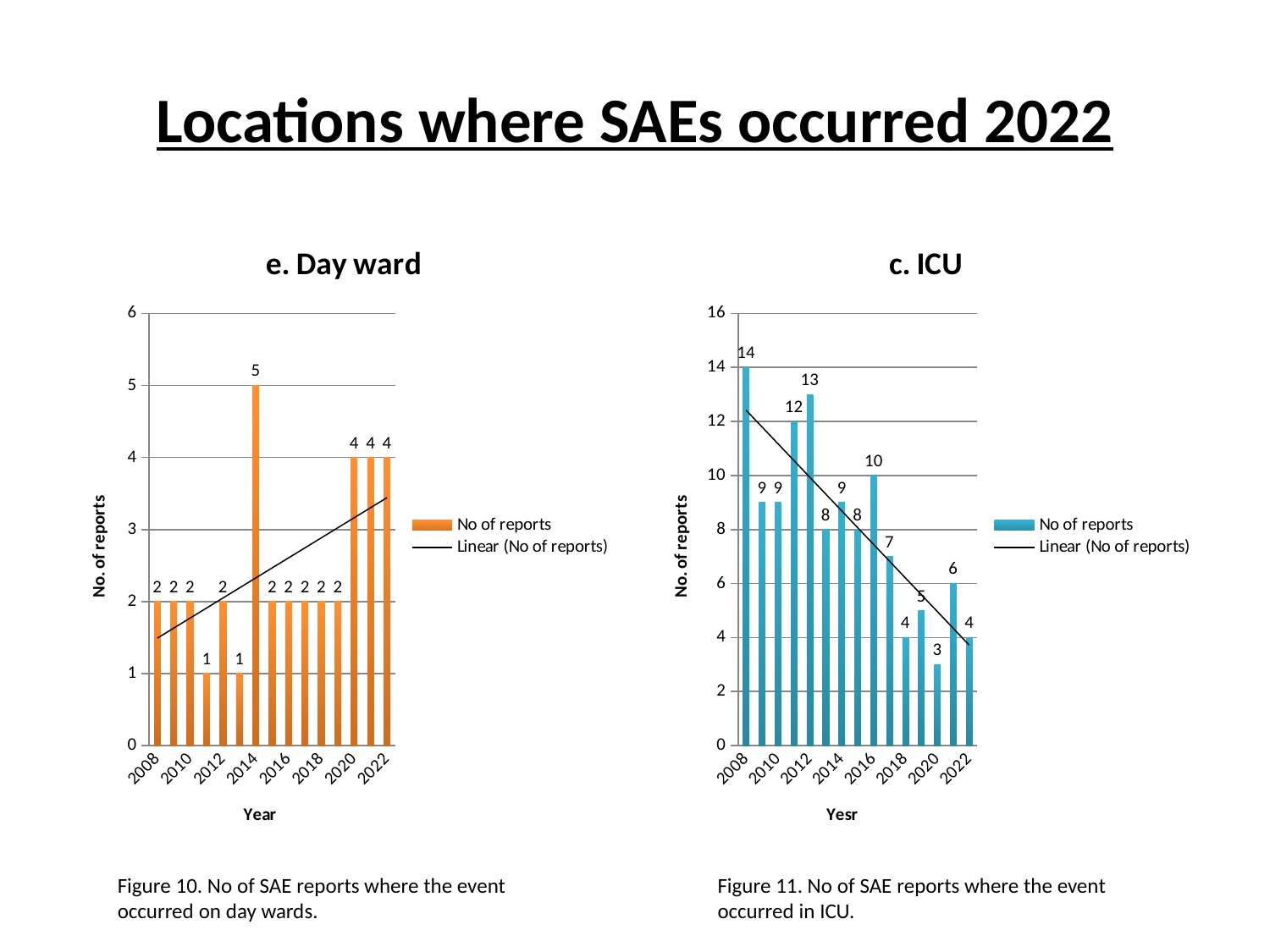
In the 'c. ICU' chart, what is the difference between the number of reports in 2008 and in 2022? 10 In the 'c. ICU' chart, which year had the lowest number of reports? 2020 In the 'c. ICU' chart, which year had more reports, 2012 or 2016? 2012 How many bars (years) are plotted in the 'c. ICU' chart? 15 In the 'c. ICU' chart, which year had the highest number of reports? 2008 In the 'c. ICU' chart, does the number of reports generally rise or fall from 2008 to 2022? fall In the 'e. Day ward' chart, how many reports were there in 2022? 4 In the 'e. Day ward' chart, how many reports were there in 2014? 5 In the 'e. Day ward' chart, which year had the highest number of reports? 2014 In the 'e. Day ward' chart, does the linear trend line rise or fall from 2008 to 2022? rise How many entries does the legend of the 'e. Day ward' chart list? 2 In the 'c. ICU' chart, how many reports were there in 2008? 14